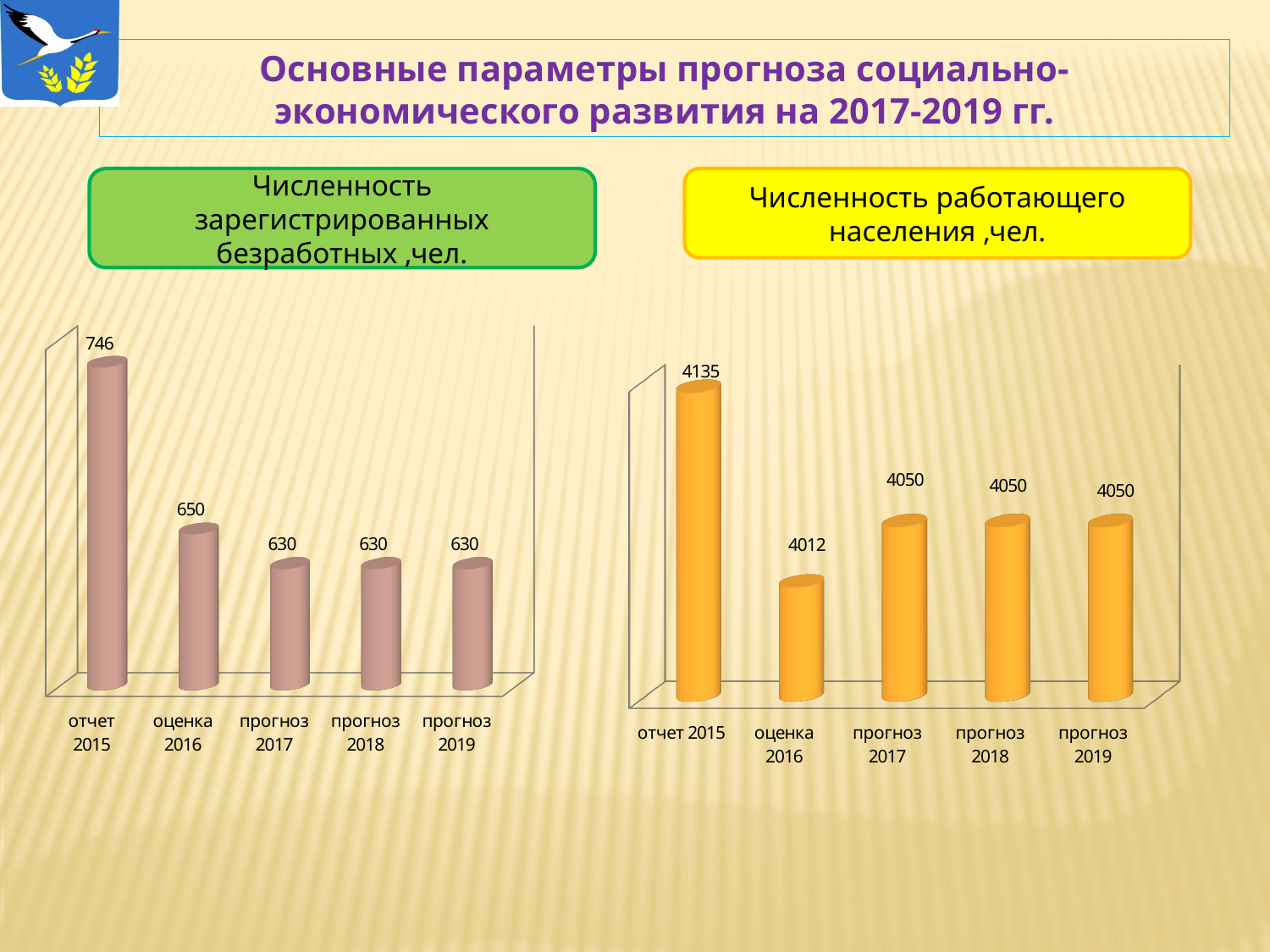
In the right chart (Численность работающего населения), what is the difference between отчет 2015 and оценка 2016? 123 In the right chart (Численность работающего населения), what is the value for оценка 2016? 4012 In the left chart (Численность зарегистрированных безработных), which category has the highest value? отчет 2015 In the right chart (Численность работающего населения), which category has the lowest value? оценка 2016 In the left chart (Численность зарегистрированных безработных), how many bars are plotted? 5 In the right chart (Численность работающего населения), what is the value for прогноз 2019? 4050 In the left chart (Численность зарегистрированных безработных), what is the value for отчет 2015? 746 What kind of chart is the right chart (Численность работающего населения)? bar chart In the left chart (Численность зарегистрированных безработных), what is the difference between отчет 2015 and прогноз 2017? 116 In the right chart (Численность работающего населения), which is larger: отчет 2015 or прогноз 2018? отчет 2015 In the left chart (Численность зарегистрированных безработных), do the values rise or fall from отчет 2015 to прогноз 2017? fall In the left chart (Численность зарегистрированных безработных), what is the value for оценка 2016? 650